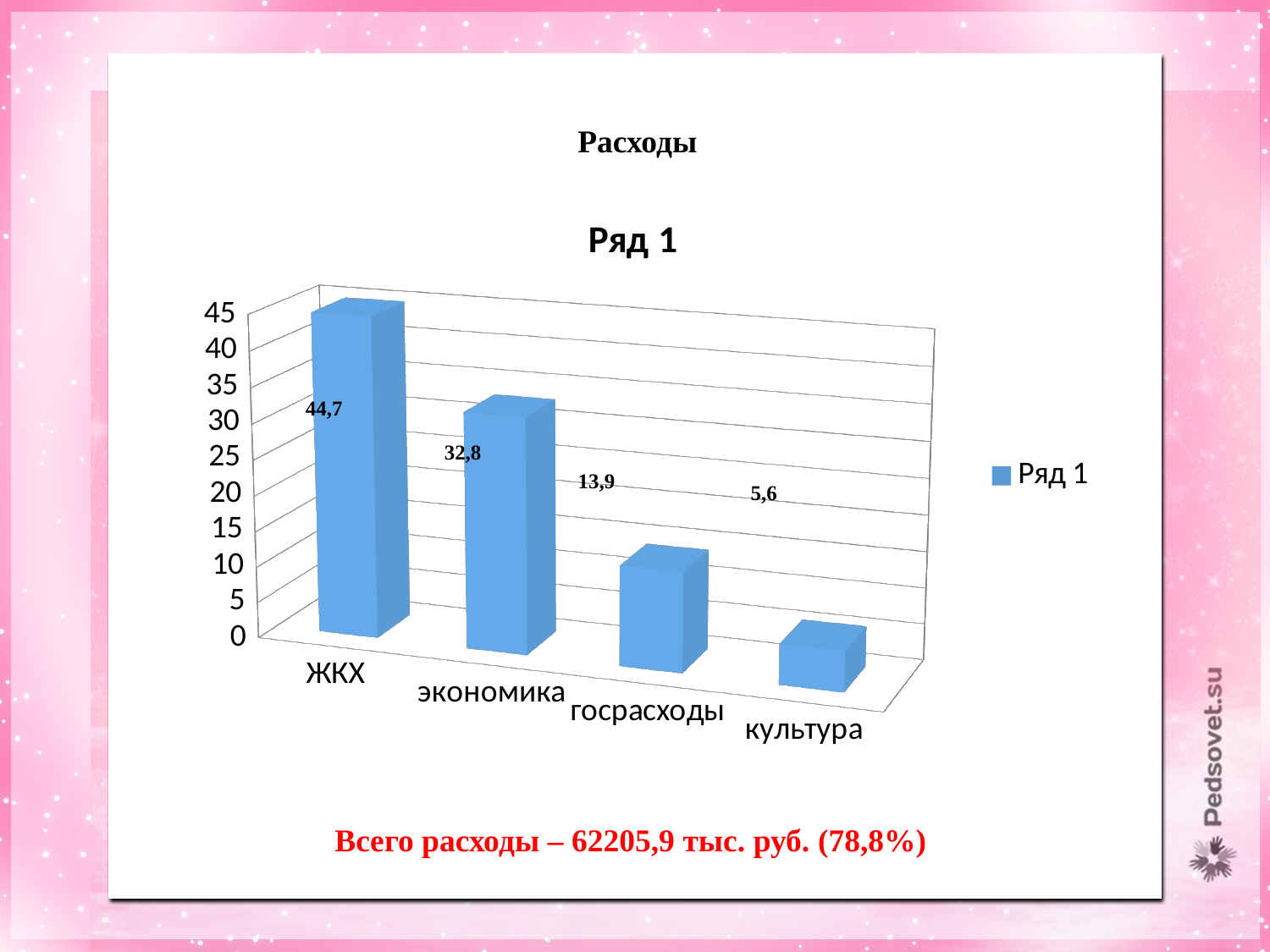
What is the value for госрасходы? 13,9 Which is larger, the value for госрасходы or the value for культура? госрасходы Which category has the highest value? ЖКХ How many categories are shown on the x axis? 4 Which category has the lowest value? культура What is the value for культура? 5,6 What is the difference between the values for ЖКХ and экономика? 11,9 What kind of chart is shown? bar chart What is the value for ЖКХ? 44,7 What is the title of the chart? Ряд 1 What is the value for экономика? 32,8 How many series does the legend list? 1